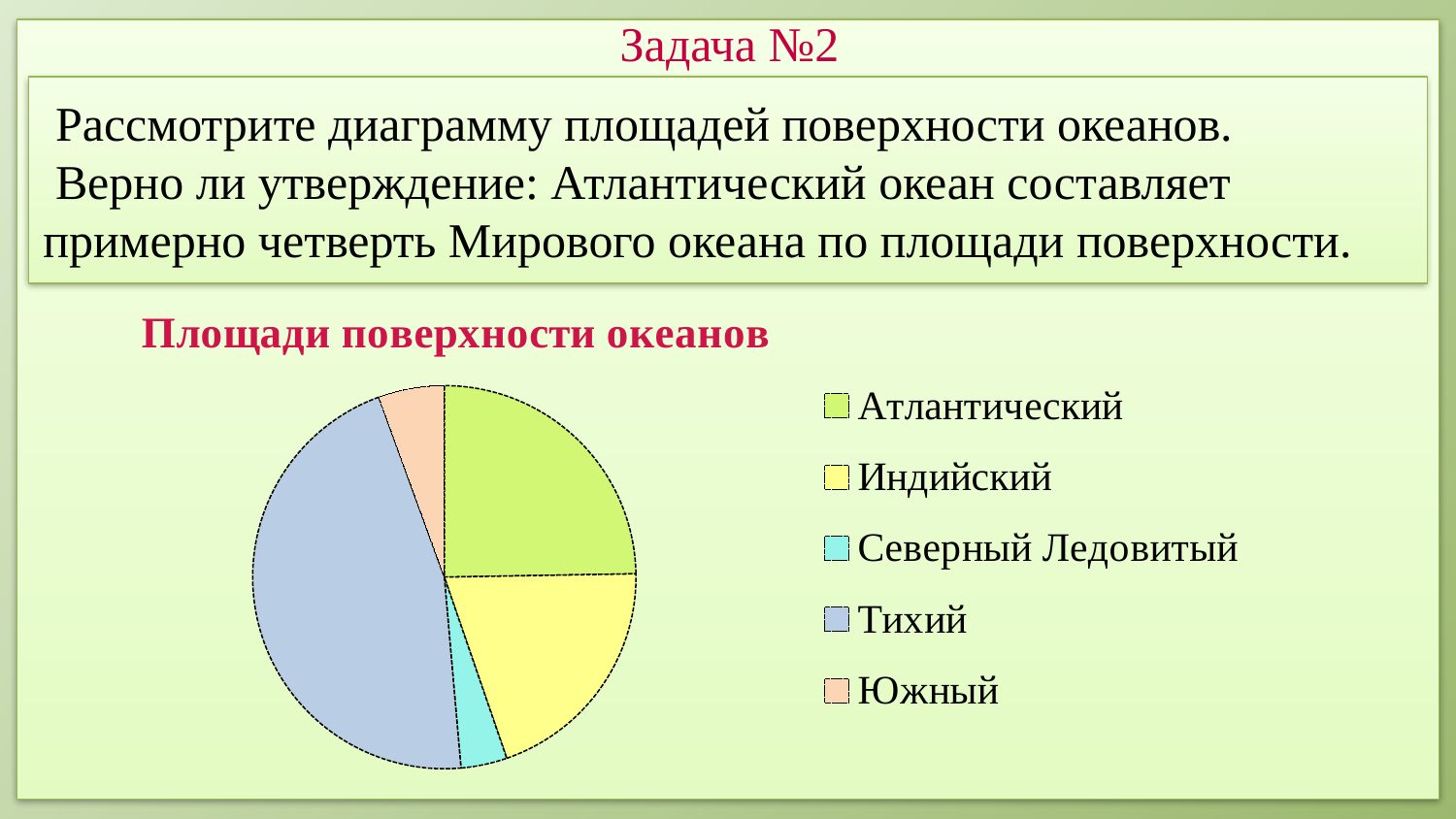
How many slices does the pie chart have? 5 Which slice is larger: Тихий or Атлантический? Тихий Which slice is larger: Атлантический or Индийский? Атлантический Which slice is larger: Южный or Северный Ледовитый? Южный What is the title of the pie chart? Площади поверхности океанов Which ocean has the largest slice in the pie chart? Тихий What kind of chart is shown on the slide? Pie chart How many entries does the legend of the pie chart list? 5 Which ocean is shown in the blue slice of the pie chart? Тихий Which ocean has the smallest slice in the pie chart? Северный Ледовитый